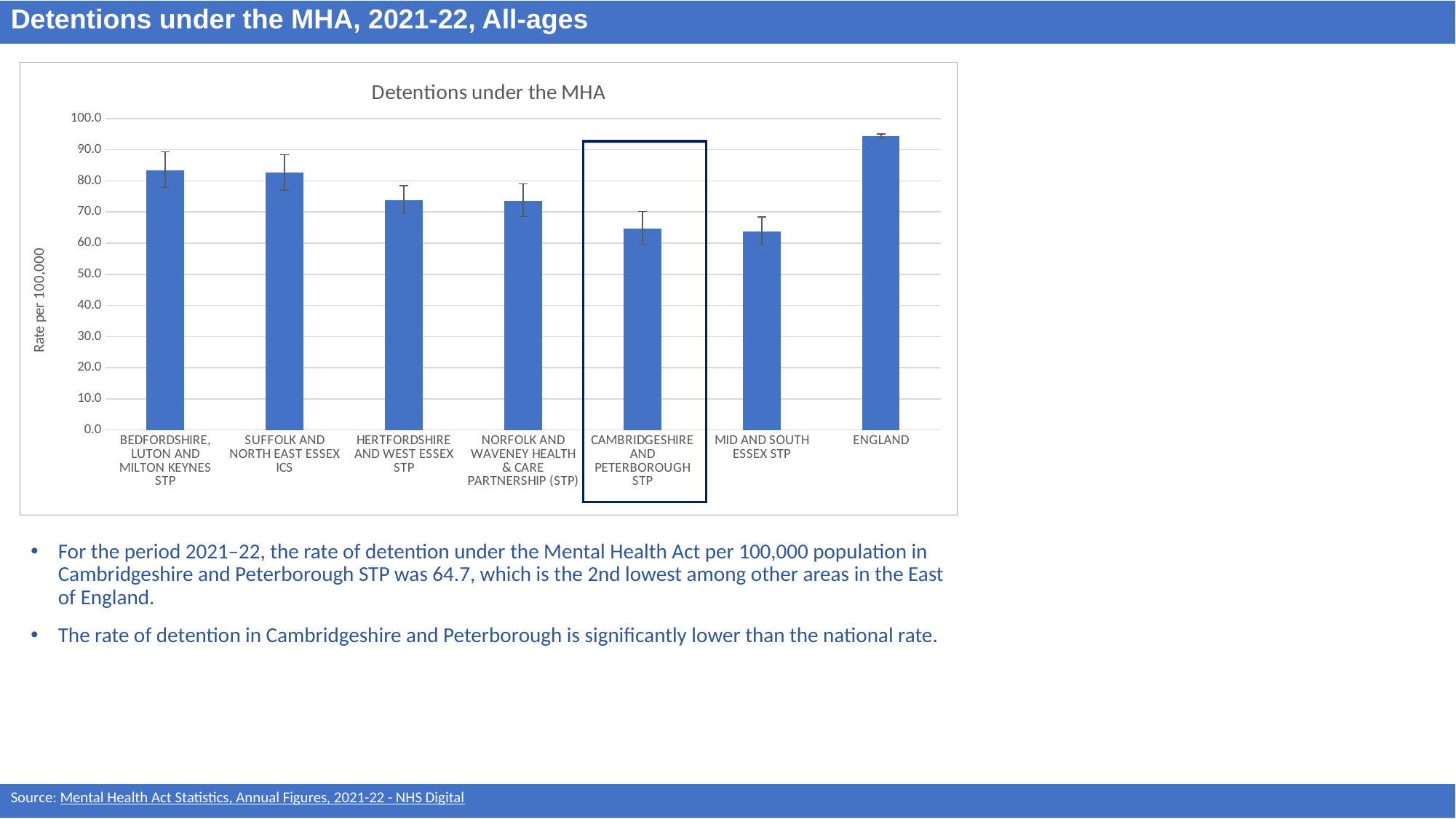
Is the value for NORFOLK AND WAVENEY HEALTH & CARE PARTNERSHIP (STP) greater or less than 80.0? less Is the value for HERTFORDSHIRE AND WEST ESSEX STP greater or less than 70.0? greater Which has the larger value, BEDFORDSHIRE, LUTON AND MILTON KEYNES STP or HERTFORDSHIRE AND WEST ESSEX STP? BEDFORDSHIRE, LUTON AND MILTON KEYNES STP Is the value for ENGLAND greater or less than 90.0? greater How many categories are plotted on the x axis of the chart? 7 Which category has the highest detention rate in the chart? ENGLAND What is the label on the y axis of the chart? Rate per 100,000 What kind of chart is shown on the slide? bar chart Which has the larger value, ENGLAND or CAMBRIDGESHIRE AND PETERBOROUGH STP? ENGLAND